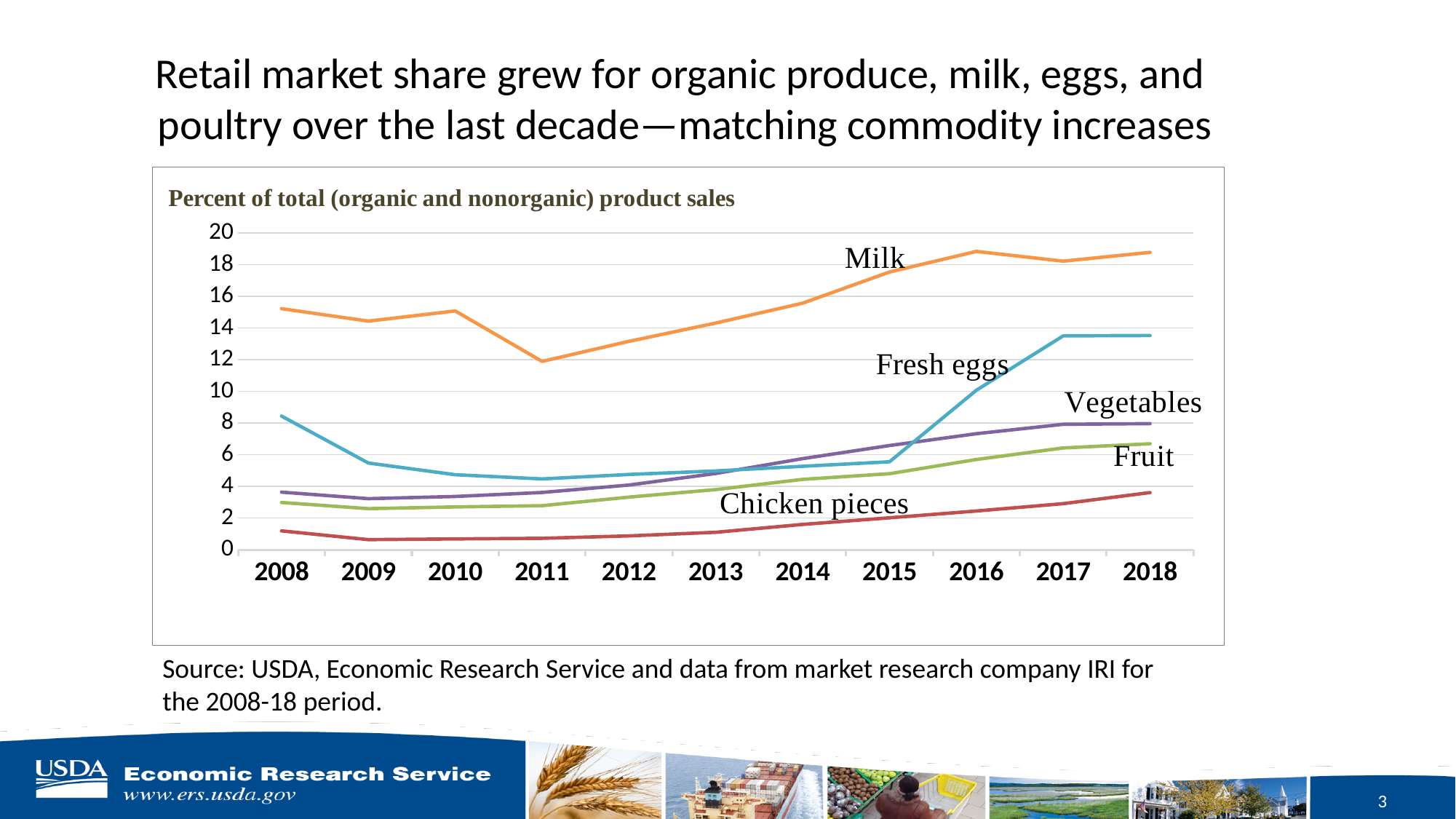
In 2008, which is larger: the value for Fresh eggs or the value for Vegetables? Fresh eggs Which product has the highest organic market share in 2018? Milk Does the Chicken pieces line rise or fall from 2011 to 2018? Rise Which product has the lowest organic market share in 2018? Chicken pieces How many product series are labelled on the chart? 5 Is the value for Chicken pieces in 2008 greater or less than 2? less Is the value for Milk in 2011 greater or less than 14? less Does the Milk line rise or fall from 2008 to 2011? Fall Is the value for Fresh eggs in 2018 greater or less than 12? greater What type of chart is shown on the slide? Line chart How many years are plotted along the x axis of the chart? 11 What does the y axis of the chart measure, according to the label above it? Percent of total (organic and nonorganic) product sales